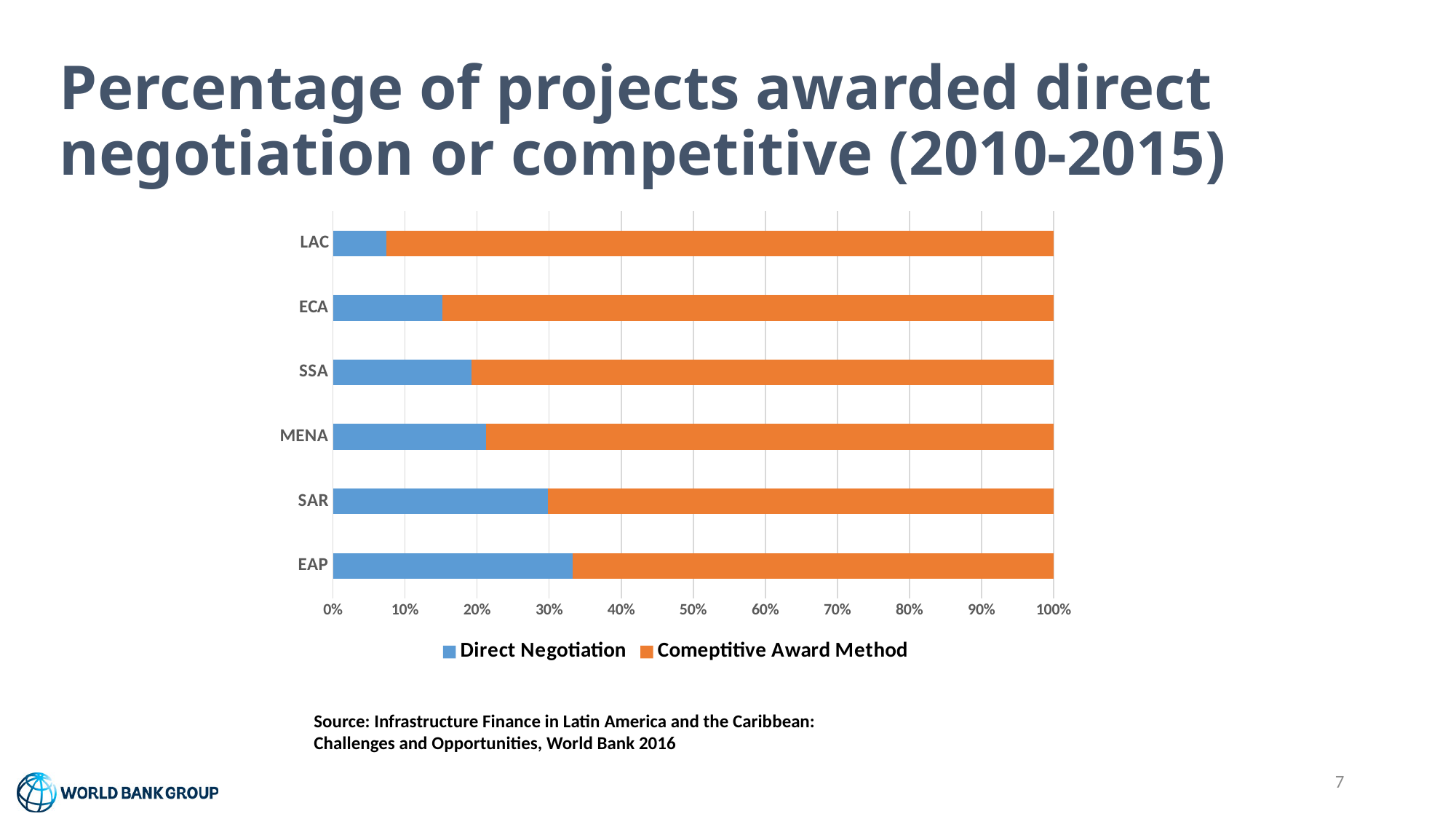
Which region has the largest share of projects awarded by the Competitive Award Method? LAC What is the total of the stacked bar for each region? 100% Is the Direct Negotiation share for ECA greater or less than 20%? less How many regions are plotted on the chart? 6 Is the Direct Negotiation share for LAC greater or less than 10%? less Which region has the lowest share of projects awarded by Direct Negotiation? LAC Is the Direct Negotiation share for EAP greater or less than 30%? greater Which region has the highest share of projects awarded by Direct Negotiation? EAP What kind of chart is shown on the slide? Stacked bar chart Which region has a larger Direct Negotiation share, SAR or MENA? SAR What are the two series named in the legend? Direct Negotiation and Comeptitive Award Method How many series does the legend list? 2